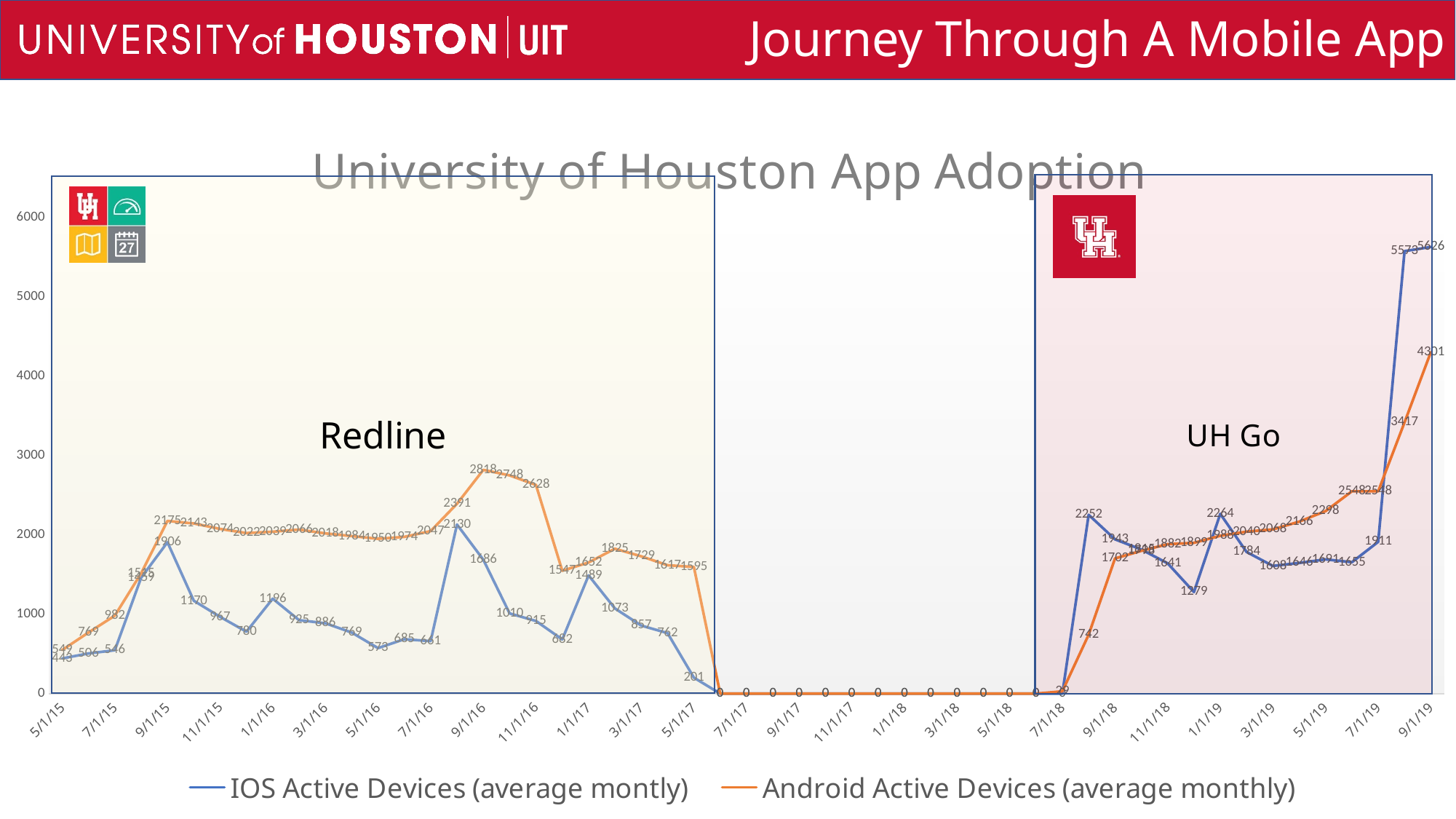
At 9/1/15, which series has the larger value, IOS or Android Active Devices? Android Active Devices Which series is drawn in orange? Android Active Devices (average monthly) What value do both series show between 7/1/17 and 5/1/18? 0 Is the IOS Active Devices value at 9/1/19 greater or less than 5000? greater How many series does the legend list? 2 What is the IOS Active Devices value at 9/1/15? 1906 What is the highest value reached by the IOS Active Devices series? 5626 What is the title of the chart? University of Houston App Adoption What type of chart is shown on the slide? line chart What is the IOS Active Devices value at 9/1/19? 5626 What is the difference between the IOS and Android Active Devices values at 9/1/19? 1325 What is the Android Active Devices value at 9/1/19? 4301